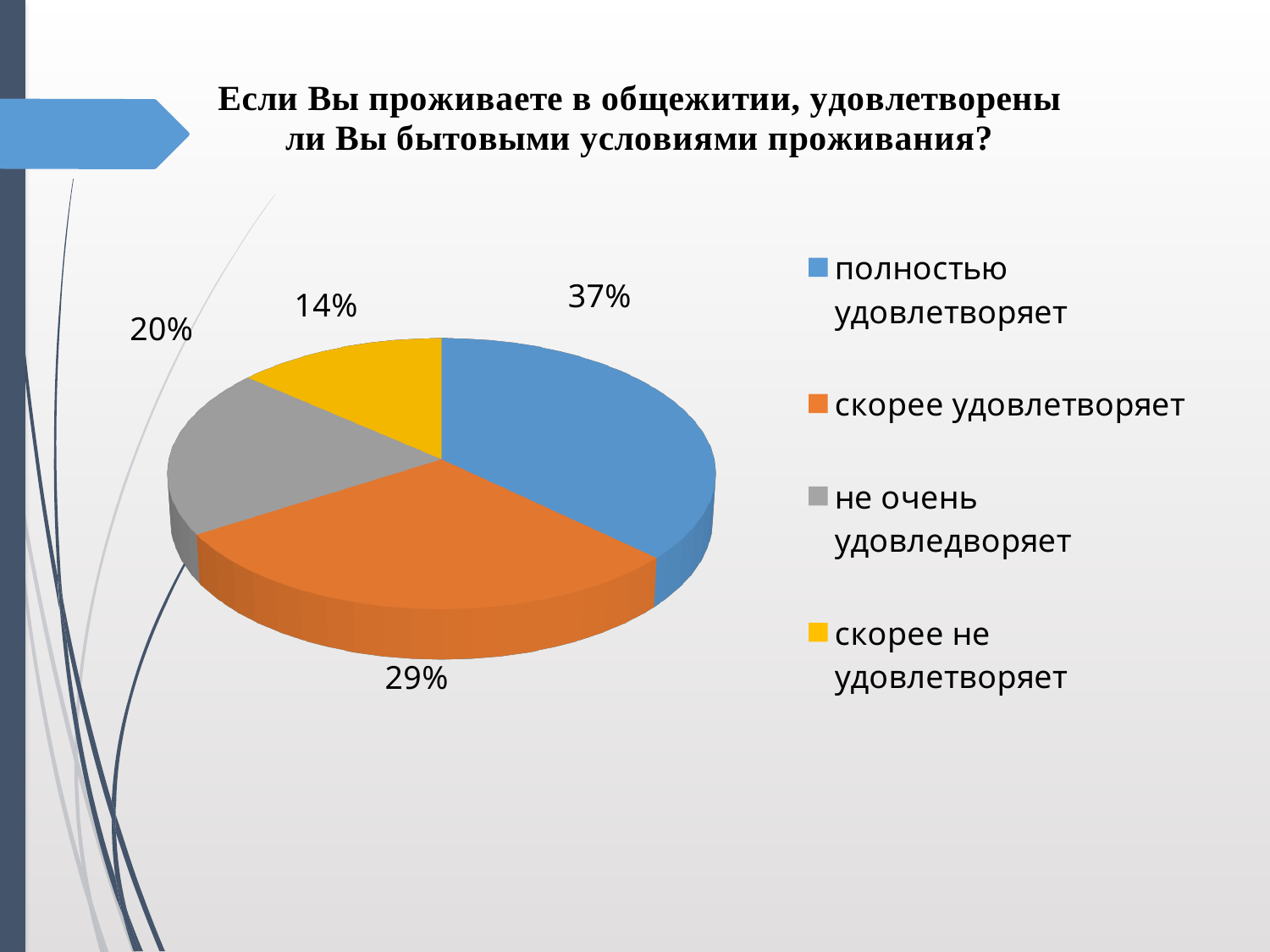
What is the difference between "полностью удовлетворяет" and "скорее удовлетворяет"? 8% Which category has the largest slice? полностью удовлетворяет What kind of chart is shown on the slide? pie chart What is the value for "скорее удовлетворяет"? 29% What is the value for "не очень удовледворяет"? 20% What is the difference between "не очень удовледворяет" and "скорее не удовлетворяет"? 6% What is the value for "скорее не удовлетворяет"? 14% How many categories does the pie chart have? 4 Which category has the smallest slice? скорее не удовлетворяет What share of the pie does "полностью удовлетворяет" have? 37% Which is larger: "скорее удовлетворяет" or "не очень удовледворяет"? скорее удовлетворяет What colour is the slice for "скорее не удовлетворяет"? yellow